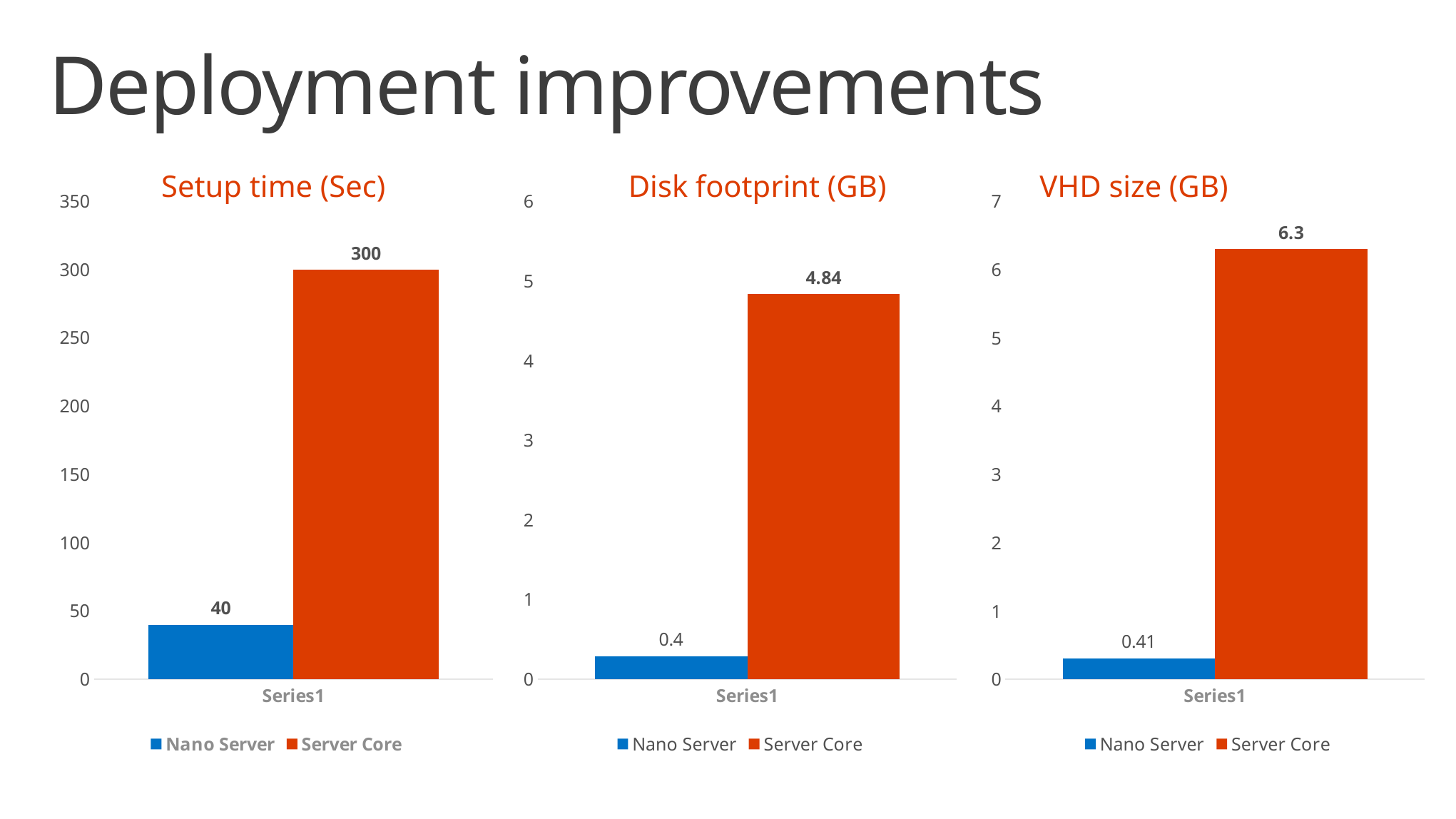
In the Disk footprint (GB) chart, what is the value for Server Core? 4.84 In the VHD size (GB) chart, what colour is the Server Core bar? Orange What kind of chart is the Setup time (Sec) chart? Bar chart In the VHD size (GB) chart, which series has the larger value, Nano Server or Server Core? Server Core In the VHD size (GB) chart, what is the value for Nano Server? 0.41 In the Disk footprint (GB) chart, what is the value for Nano Server? 0.4 In the Setup time (Sec) chart, what is the value for Nano Server? 40 In the Setup time (Sec) chart, what is the difference between the Server Core and Nano Server values? 260 How many series does the legend of the Disk footprint (GB) chart list? 2 In the VHD size (GB) chart, what is the value for Server Core? 6.3 In the Setup time (Sec) chart, what is the value for Server Core? 300 In the Disk footprint (GB) chart, which series has the lowest value? Nano Server